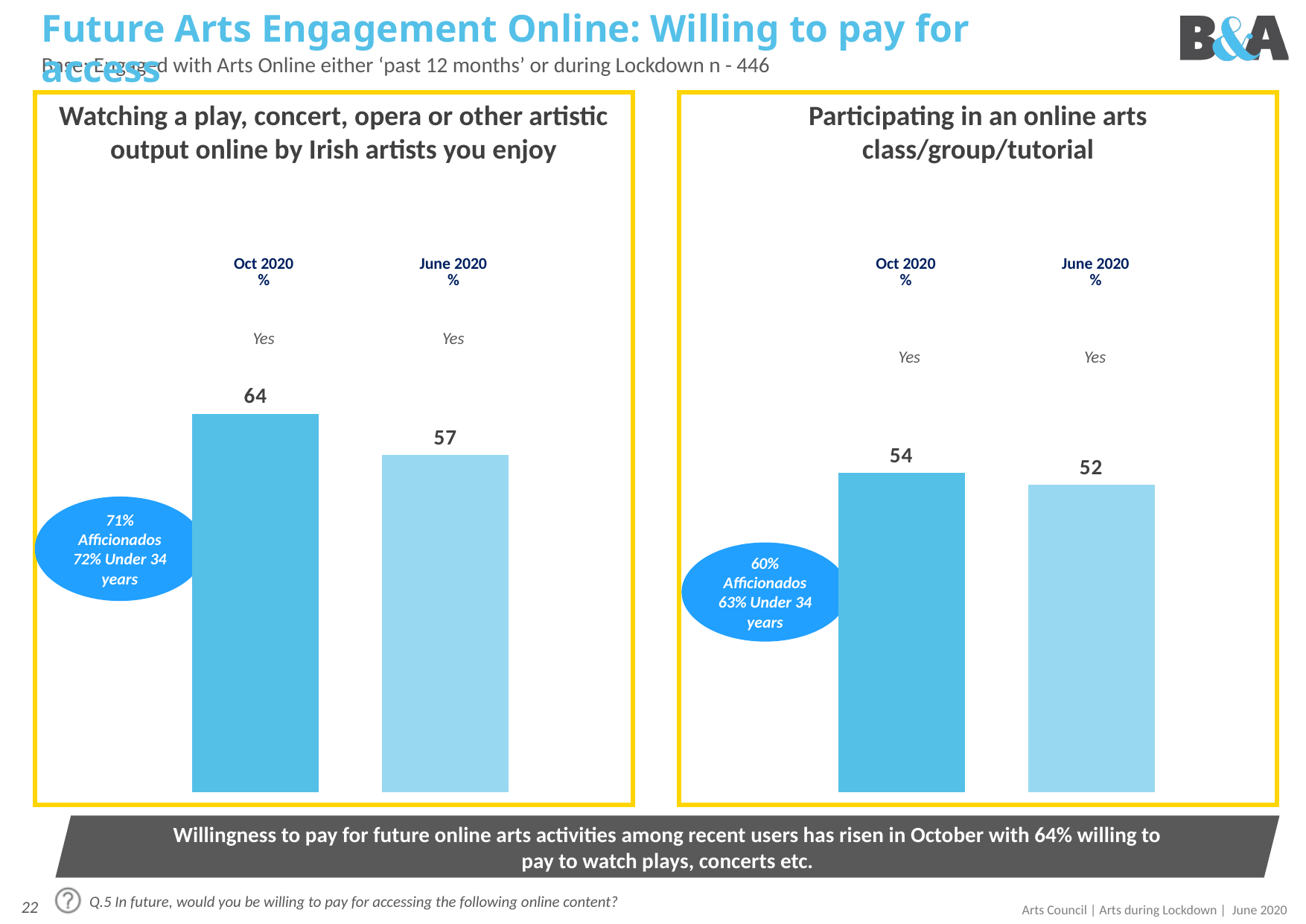
In the 'Participating in an online arts class/group/tutorial' chart, what is the value for Oct 2020? 54 In the 'Watching a play, concert, opera or other artistic output online by Irish artists you enjoy' chart, what is the value for Oct 2020? 64 In the 'Watching a play, concert, opera or other artistic output online by Irish artists you enjoy' chart, what is the difference between the Oct 2020 and June 2020 values? 7 In the 'Participating in an online arts class/group/tutorial' chart, which period has the lower value? June 2020 Is the Oct 2020 value in the left chart larger than the Oct 2020 value in the right chart? Yes In the 'Watching a play, concert, opera or other artistic output online by Irish artists you enjoy' chart, how many bars are plotted? 2 In the 'Watching a play, concert, opera or other artistic output online by Irish artists you enjoy' chart, what is the value for June 2020? 57 In the 'Participating in an online arts class/group/tutorial' chart, what is the difference between the Oct 2020 and June 2020 values? 2 What does the callout bubble on the 'Participating in an online arts class/group/tutorial' chart say? 60% Afficionados 63% Under 34 years In the 'Participating in an online arts class/group/tutorial' chart, what is the value for June 2020? 52 In the 'Watching a play, concert, opera or other artistic output online by Irish artists you enjoy' chart, which period has the higher value? Oct 2020 What type of chart is the 'Participating in an online arts class/group/tutorial' chart? Bar chart